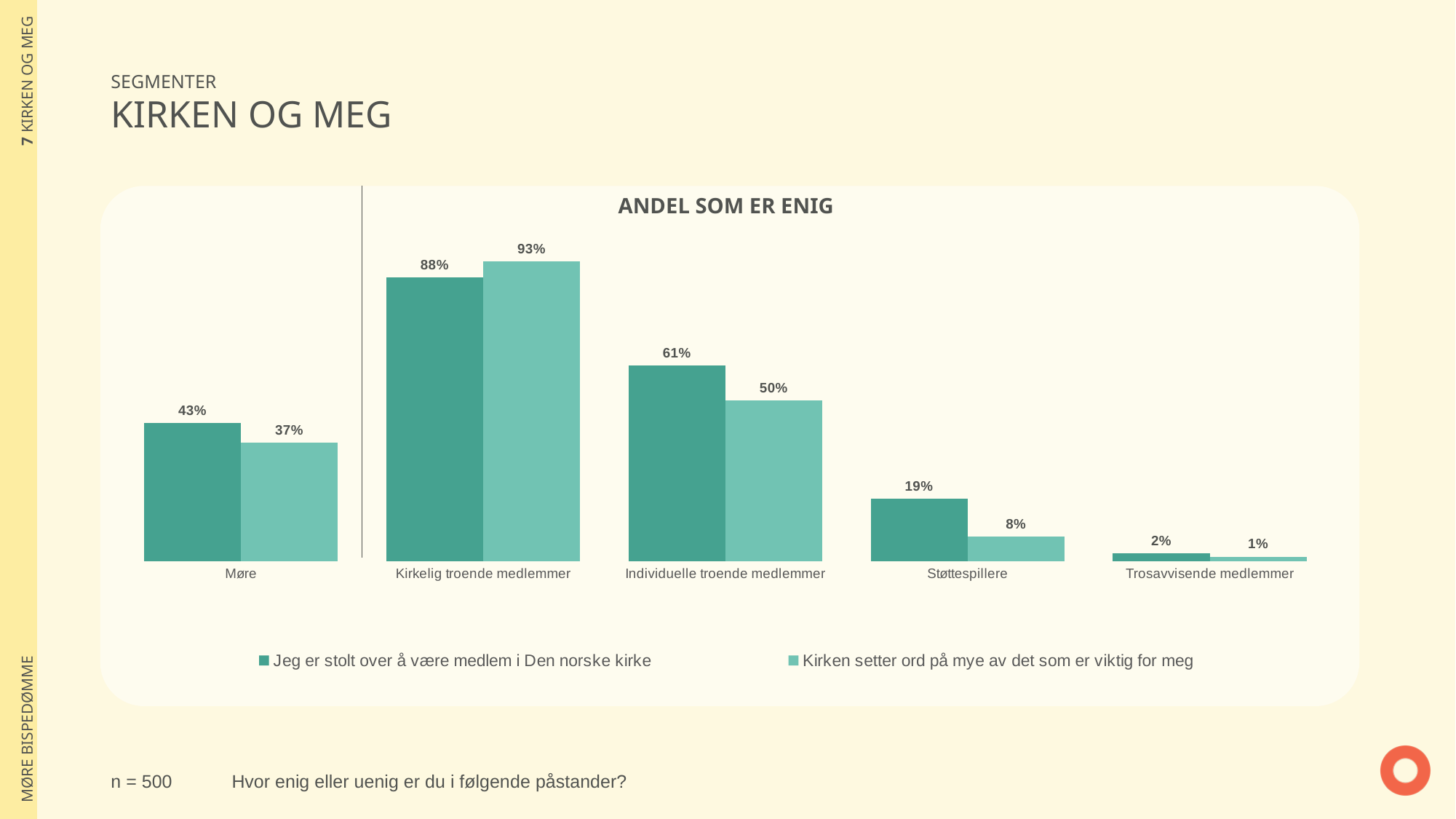
What is the value for Støttespillere for the series "Kirken setter ord på mye av det som er viktig for meg"? 8% How many series does the legend list? 2 What is the value for Møre for the series "Jeg er stolt over å være medlem i Den norske kirke"? 43% What is the difference between the value for Kirkelig troende medlemmer and Støttespillere for the series "Jeg er stolt over å være medlem i Den norske kirke"? 69 percentage points What is the value for Kirkelig troende medlemmer for the series "Kirken setter ord på mye av det som er viktig for meg"? 93% What is the difference between the two series for Individuelle troende medlemmer? 11 percentage points How many categories are shown on the x axis? 5 For Møre, which series has the larger value? Jeg er stolt over å være medlem i Den norske kirke Which category has the highest value for the series "Jeg er stolt over å være medlem i Den norske kirke"? Kirkelig troende medlemmer What kind of chart is shown on the slide? Bar chart What is the title of the chart? ANDEL SOM ER ENIG Which category has the lowest value for the series "Kirken setter ord på mye av det som er viktig for meg"? Trosavvisende medlemmer